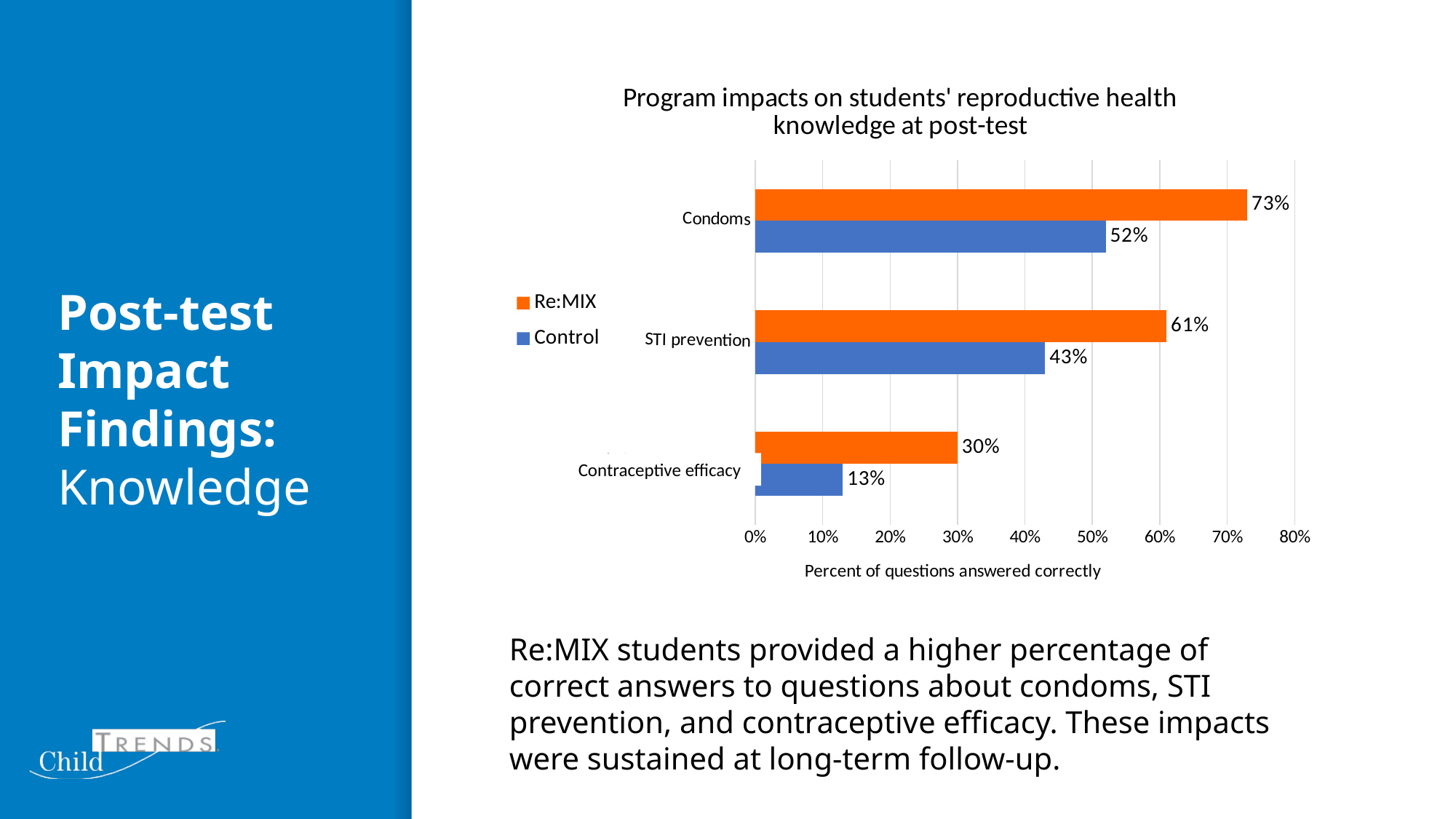
What is the Re:MIX value for contraceptive efficacy? 30% What kind of chart is shown on the slide? Bar chart What is the label of the horizontal axis? Percent of questions answered correctly Which category has the highest Re:MIX value? Condoms How many series does the legend list? 2 What is the Control group's value for STI prevention? 43% Which is larger for STI prevention, the Re:MIX value or the Control value? Re:MIX Which category has the lowest Control value? Contraceptive efficacy How many categories are shown on the chart? 3 What percentage of questions about condoms did Re:MIX students answer correctly? 73% What is the difference between the Re:MIX and Control values for contraceptive efficacy? 17 percentage points What is the difference between the Re:MIX and Control values for condoms? 21 percentage points